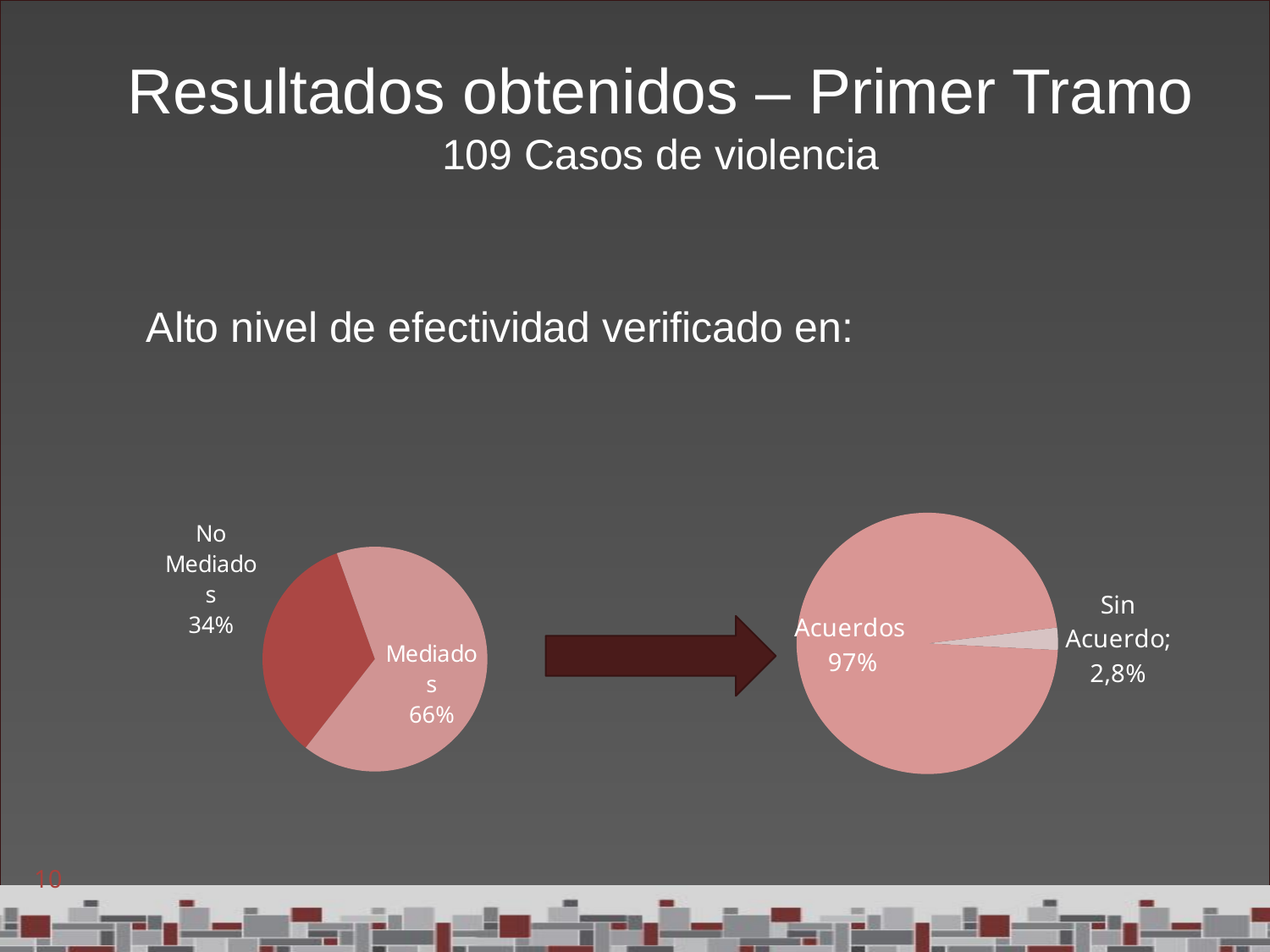
In the left pie chart, what is the difference in percentage points between Mediados and No Mediados? 32 In the right pie chart, what share is labelled for Sin Acuerdo? 2,8% In the left pie chart, what share is labelled for No Mediados? 34% How many pie charts are shown on the slide? 2 How many slices does the left pie chart have? 2 In the right pie chart, what share is labelled for Acuerdos? 97% In the left pie chart, which slice is the largest? Mediados In the left pie chart, which is larger, Mediados or No Mediados? Mediados In the left pie chart, what share is labelled for Mediados? 66% How many slices does the right pie chart have? 2 In the right pie chart, which slice is the smallest? Sin Acuerdo What kind of chart is the right chart on the slide? Pie chart